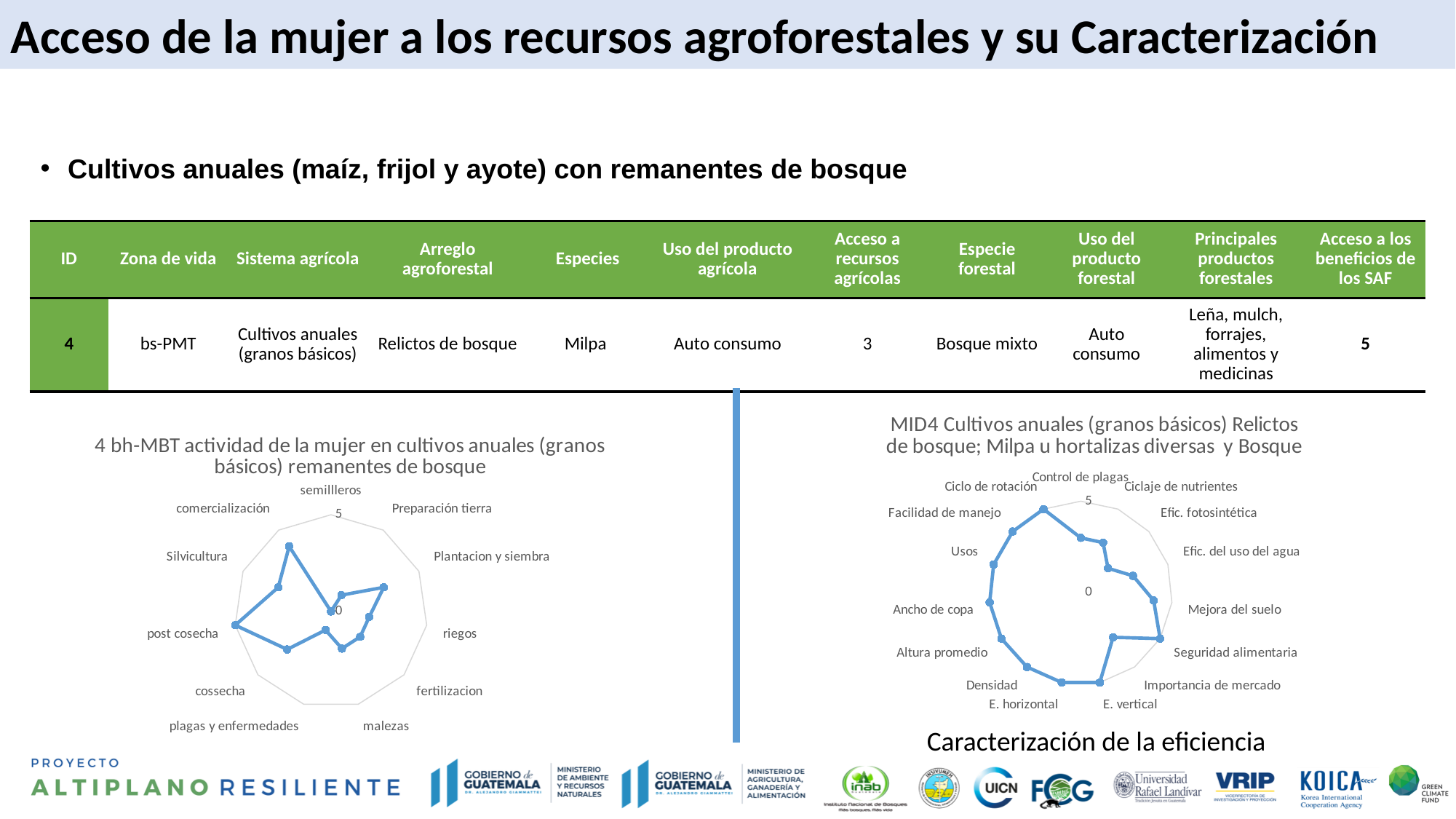
How many categories are plotted on the left radar chart (4 bh-MBT actividad de la mujer)? 11 On the left radar chart (4 bh-MBT actividad de la mujer), is the value for Plantacion y siembra greater or less than 5? less On the left radar chart (4 bh-MBT actividad de la mujer), which is larger: post cosecha or semillleros? post cosecha On the left radar chart (4 bh-MBT actividad de la mujer), which is larger: Plantacion y siembra or Preparación tierra? Plantacion y siembra On the left radar chart (4 bh-MBT actividad de la mujer), which category has the highest value? post cosecha How many categories are plotted on the right radar chart (MID4 Cultivos anuales)? 15 What kind of chart is the left chart titled '4 bh-MBT actividad de la mujer en cultivos anuales (granos básicos) remanentes de bosque'? Radar chart What is the maximum value shown on the axis scale of the right radar chart (MID4 Cultivos anuales)? 5 What text appears below the right radar chart (MID4 Cultivos anuales)? Caracterización de la eficiencia What kind of chart is the right chart titled 'MID4 Cultivos anuales (granos básicos) Relictos de bosque; Milpa u hortalizas diversas y Bosque'? Radar chart On the right radar chart (MID4 Cultivos anuales), which is larger: Seguridad alimentaria or Efic. fotosintética? Seguridad alimentaria